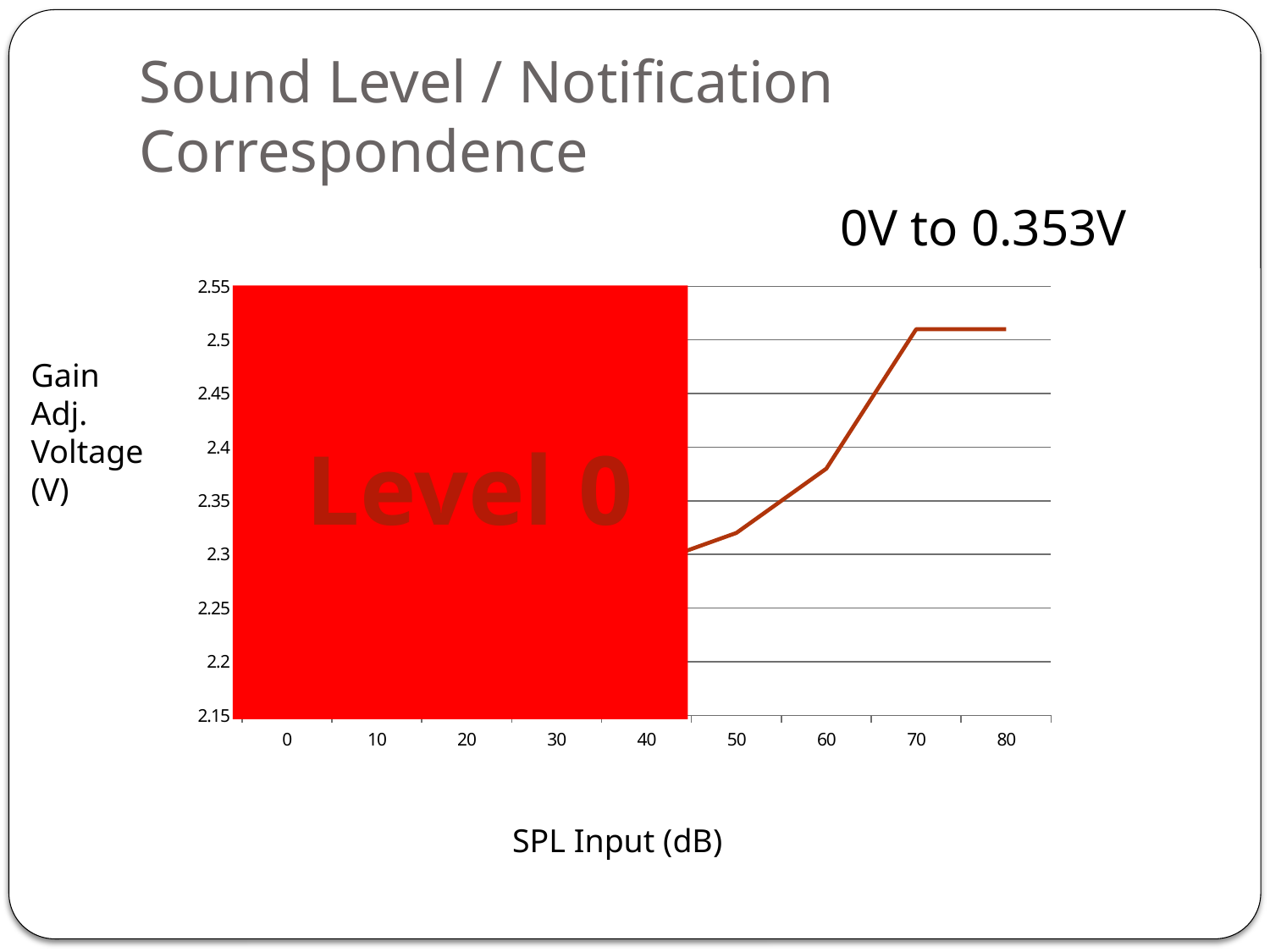
Is the value at an SPL input of 80 dB greater or less than 2.45? greater Which is larger, the value at 60 dB or the value at 50 dB? 60 dB Which is larger, the value at 70 dB or the value at 60 dB? 70 dB Is the value at an SPL input of 50 dB greater or less than 2.35? less Does the line rise or fall between 50 dB and 70 dB? rise What is the title of the x axis of the chart? SPL Input (dB) What is the highest value shown on the y axis of the chart? 2.55 Is the value at an SPL input of 50 dB greater or less than 2.3? greater What kind of chart is shown on the slide? line chart Does the line rise, fall or stay flat between 70 dB and 80 dB? stay flat What label is printed inside the red box on the chart? Level 0